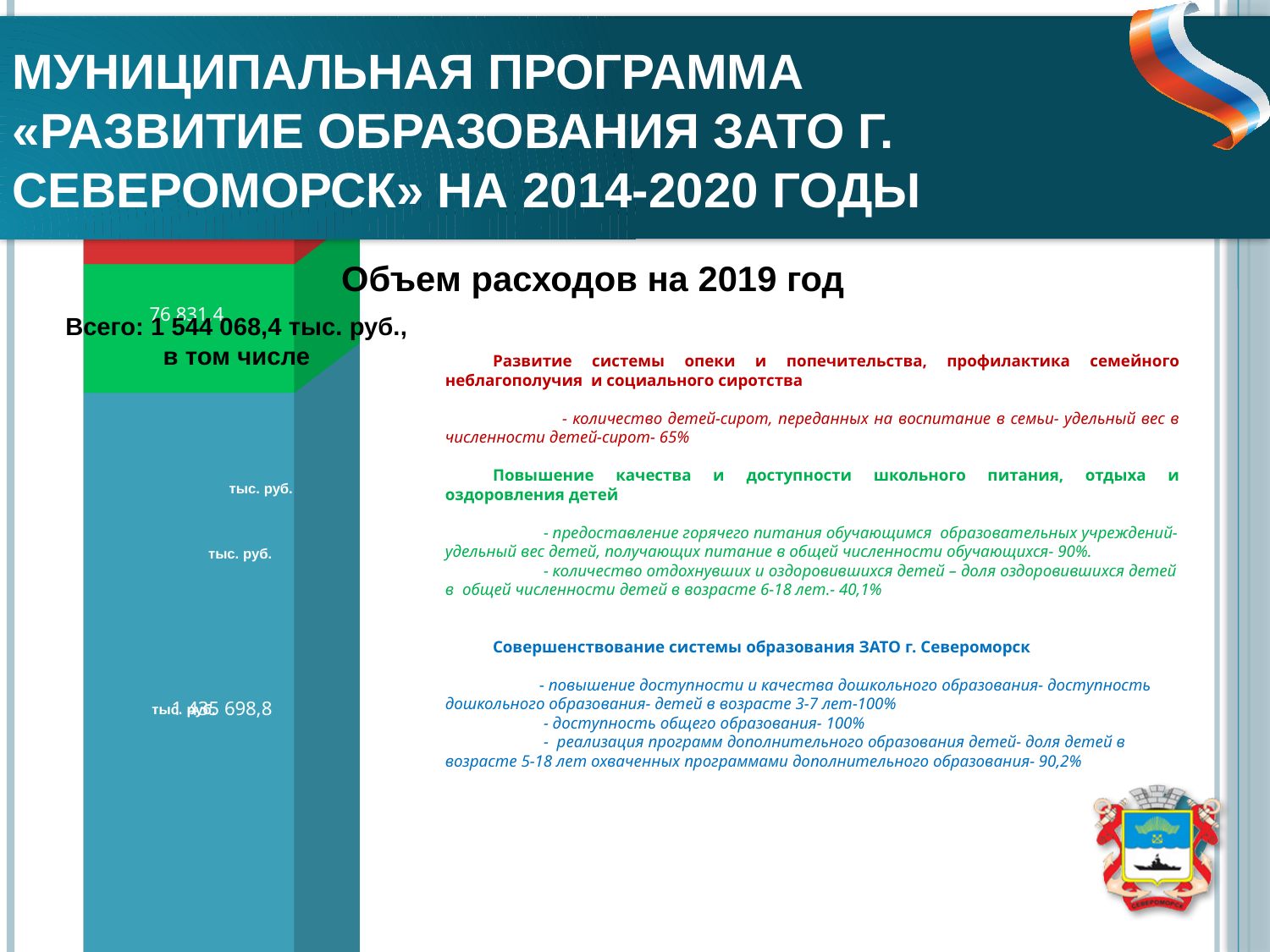
What value is printed on the green segment of the stacked bar? 76 831,4 Which colour segment of the stacked bar is the smallest? red What is the difference between the blue segment value (1 435 698,8) and the green segment value (76 831,4)? 1 358 867,4 What total amount is stated above the chart for the stacked bar? 1 544 068,4 тыс. руб. What kind of chart is shown on the left of the slide? stacked bar chart What unit is printed on the segments of the stacked bar? тыс. руб. Which colour segment of the stacked bar is the largest? blue What is the title printed above the chart area? Объем расходов на 2019 год Which segment of the stacked bar is larger, the green one or the blue one? the blue one How many segments does the stacked bar have? 3 What value is printed on the blue segment of the stacked bar? 1 435 698,8